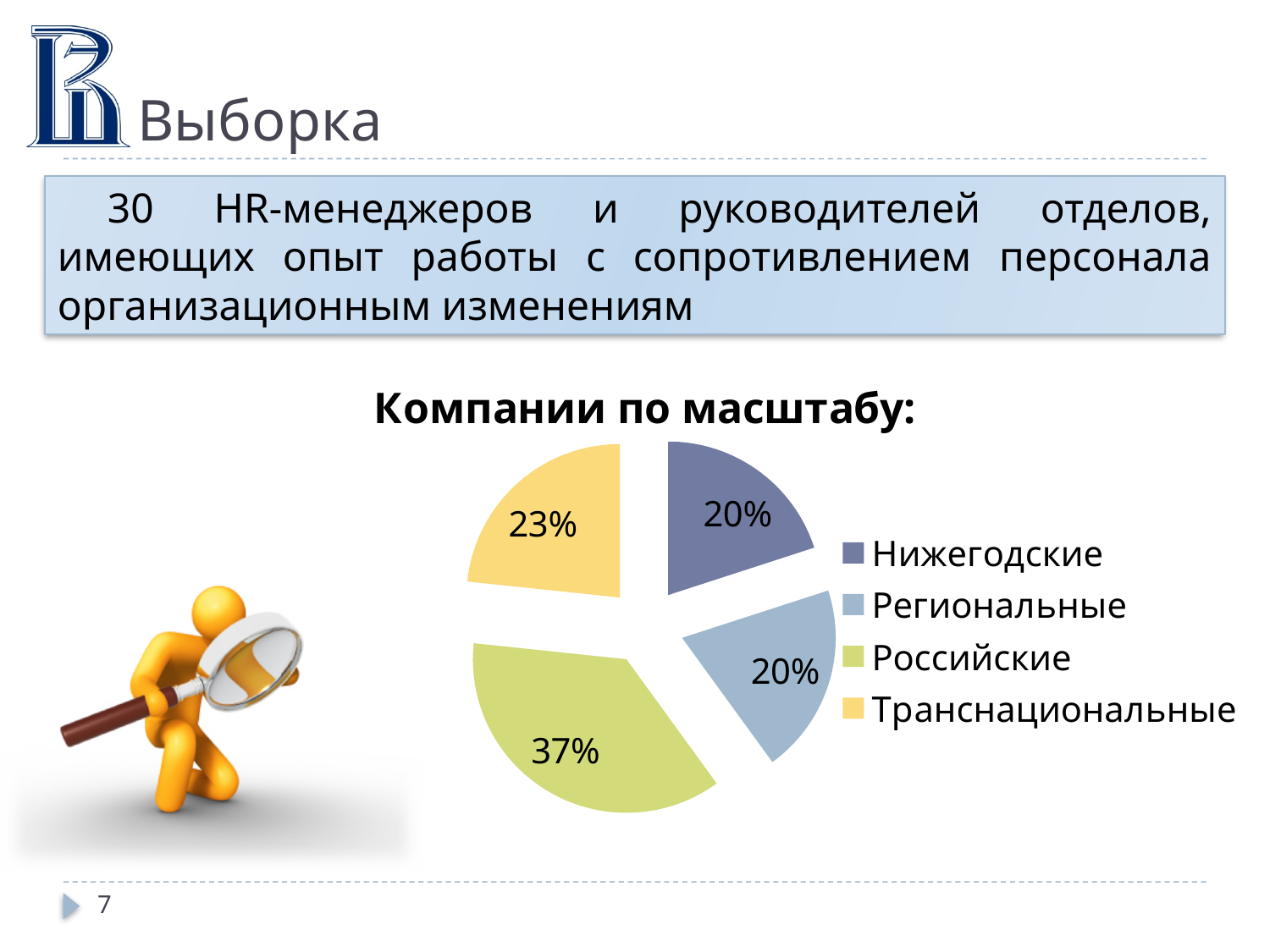
What share of the pie is labelled Российские? 37% What type of chart is shown on the slide? pie chart Which is larger, the share for Транснациональные or the share for Нижегодские? Транснациональные What share of the pie is labelled Нижегодские? 20% How many entries does the legend list? 4 Which category has the largest slice of the pie? Российские What is the title of the chart? Компании по масштабу: How many slices does the pie chart have? 4 What share of the pie is labelled Транснациональные? 23% What is the difference between the shares for Российские and Транснациональные? 14% Which legend entry is shown in yellow? Транснациональные What share of the pie is labelled Региональные? 20%